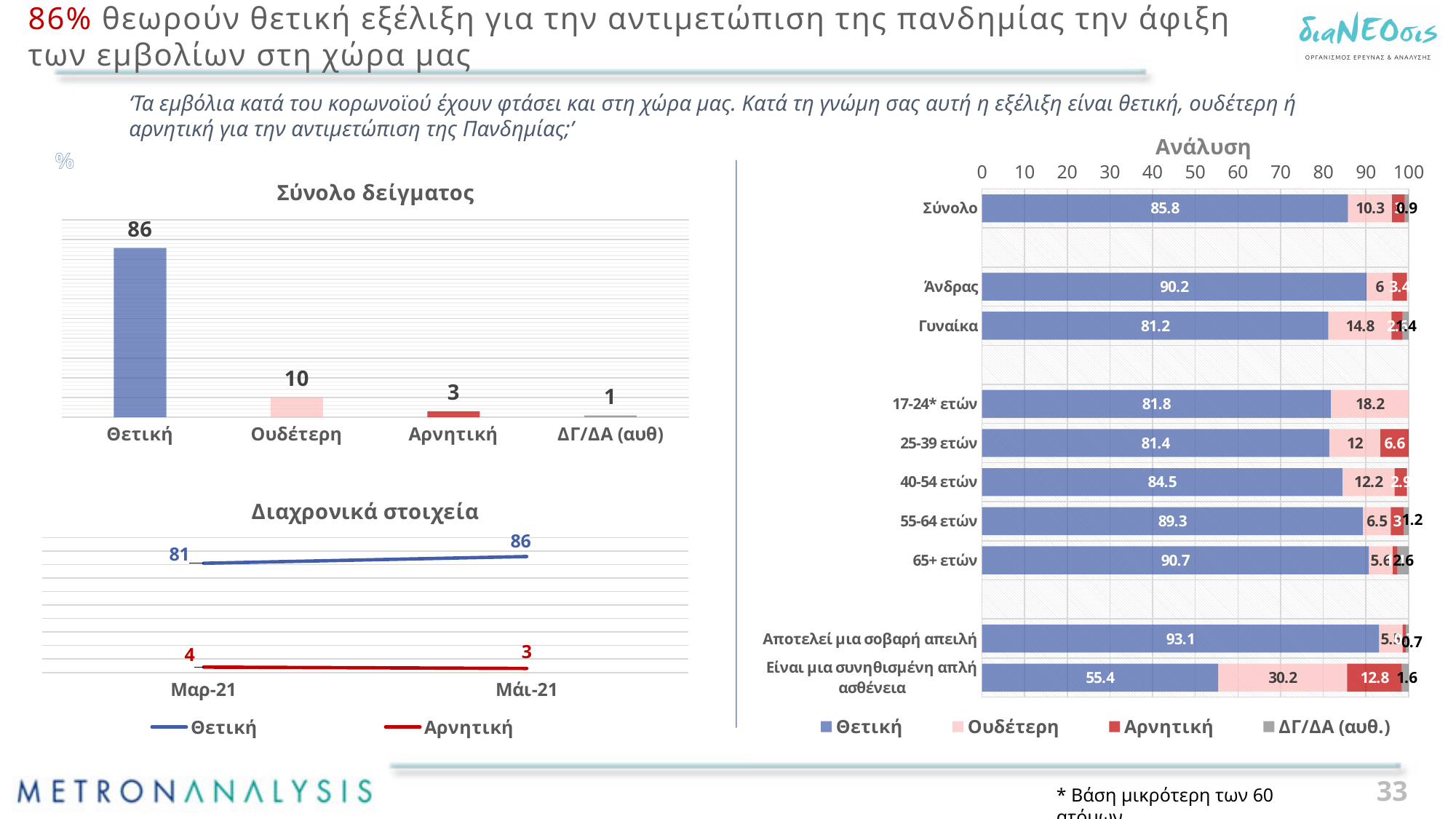
In the 'Διαχρονικά στοιχεία' chart, does the Θετική line rise or fall from Μαρ-21 to Μάι-21? rise In the 'Ανάλυση' chart, which category has the highest Θετική value? Αποτελεί μια σοβαρή απειλή In the 'Διαχρονικά στοιχεία' chart, how many series does the legend list? 2 In the 'Σύνολο δείγματος' chart, what is the difference between Ουδέτερη and Αρνητική? 7 In the 'Σύνολο δείγματος' chart, what is the value for Θετική? 86 In the 'Ανάλυση' chart, what is the Θετική value for 65+ ετών? 90.7 In the 'Ανάλυση' chart, what is the difference in Θετική between Άνδρας and Γυναίκα? 9.0 In the 'Διαχρονικά στοιχεία' chart, what is the value for Θετική at Μαρ-21? 81 In the 'Ανάλυση' chart, which is larger: the Ουδέτερη value for 17-24* ετών or for 25-39 ετών? 17-24* ετών In the 'Σύνολο δείγματος' chart, which category has the lowest value? ΔΓ/ΔΑ (αυθ) In the 'Σύνολο δείγματος' chart, how many categories are shown? 4 What kind of chart is the 'Ανάλυση' chart? stacked bar chart